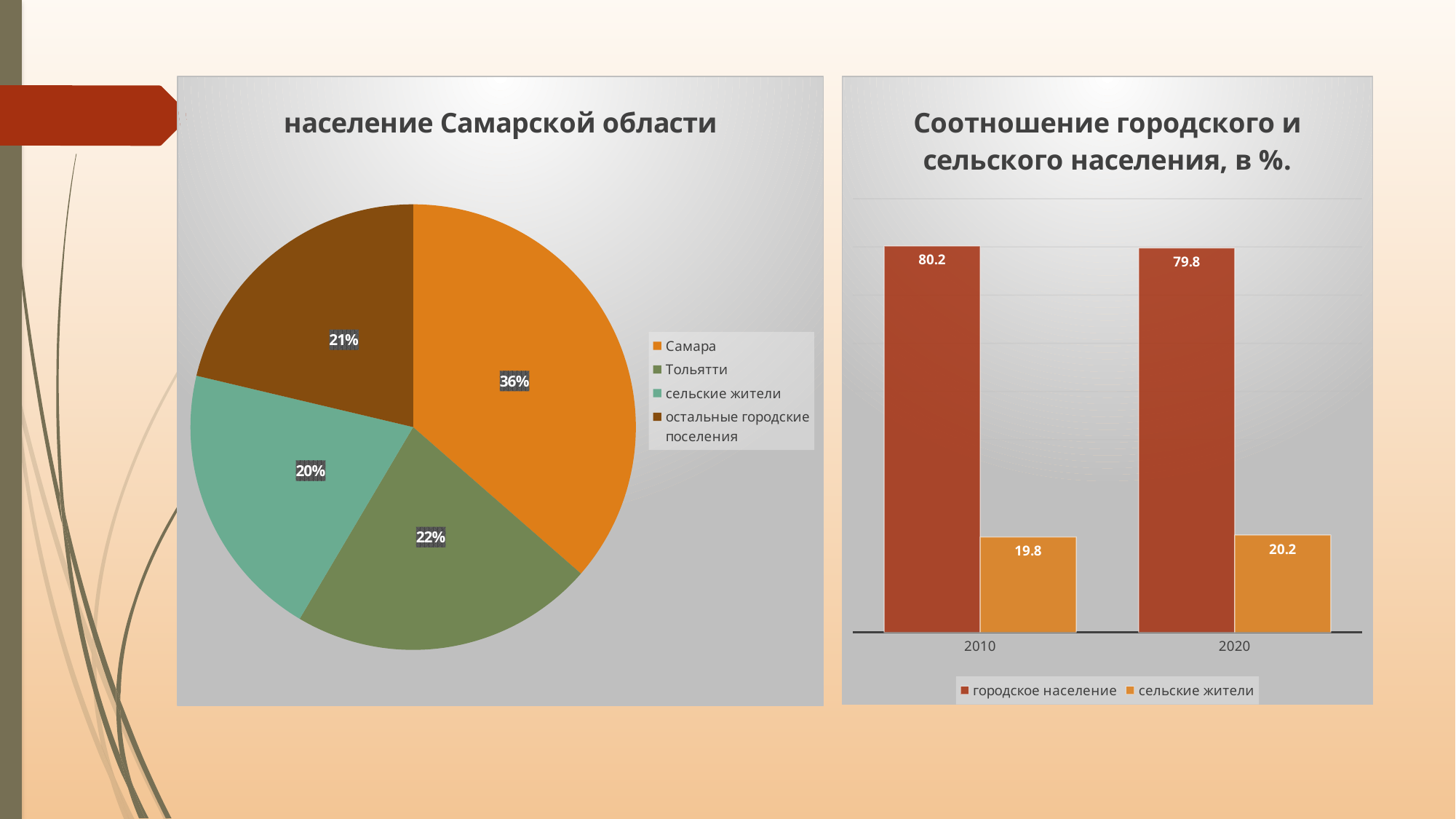
In the pie chart 'население Самарской области', how many slices are there? 4 In the pie chart 'население Самарской области', what share does Самара have? 36% In the pie chart 'население Самарской области', which category has the smallest share? сельские жители In the chart 'Соотношение городского и сельского населения, в %.', how many series does the legend list? 2 In the chart 'Соотношение городского и сельского населения, в %.', what is the value for городское население in 2010? 80.2 In the pie chart 'население Самарской области', what is the difference between the shares of Самара and остальные городские поселения? 15% In the pie chart 'население Самарской области', which category has the largest share? Самара What kind of chart is the right chart 'Соотношение городского и сельского населения, в %.'? bar chart In the pie chart 'население Самарской области', what share does Тольятти have? 22% What kind of chart is the left chart 'население Самарской области'? pie chart In the chart 'Соотношение городского и сельского населения, в %.', what is the difference between городское население in 2010 and in 2020? 0.4 In the chart 'Соотношение городского и сельского населения, в %.', what is the value for сельские жители in 2020? 20.2